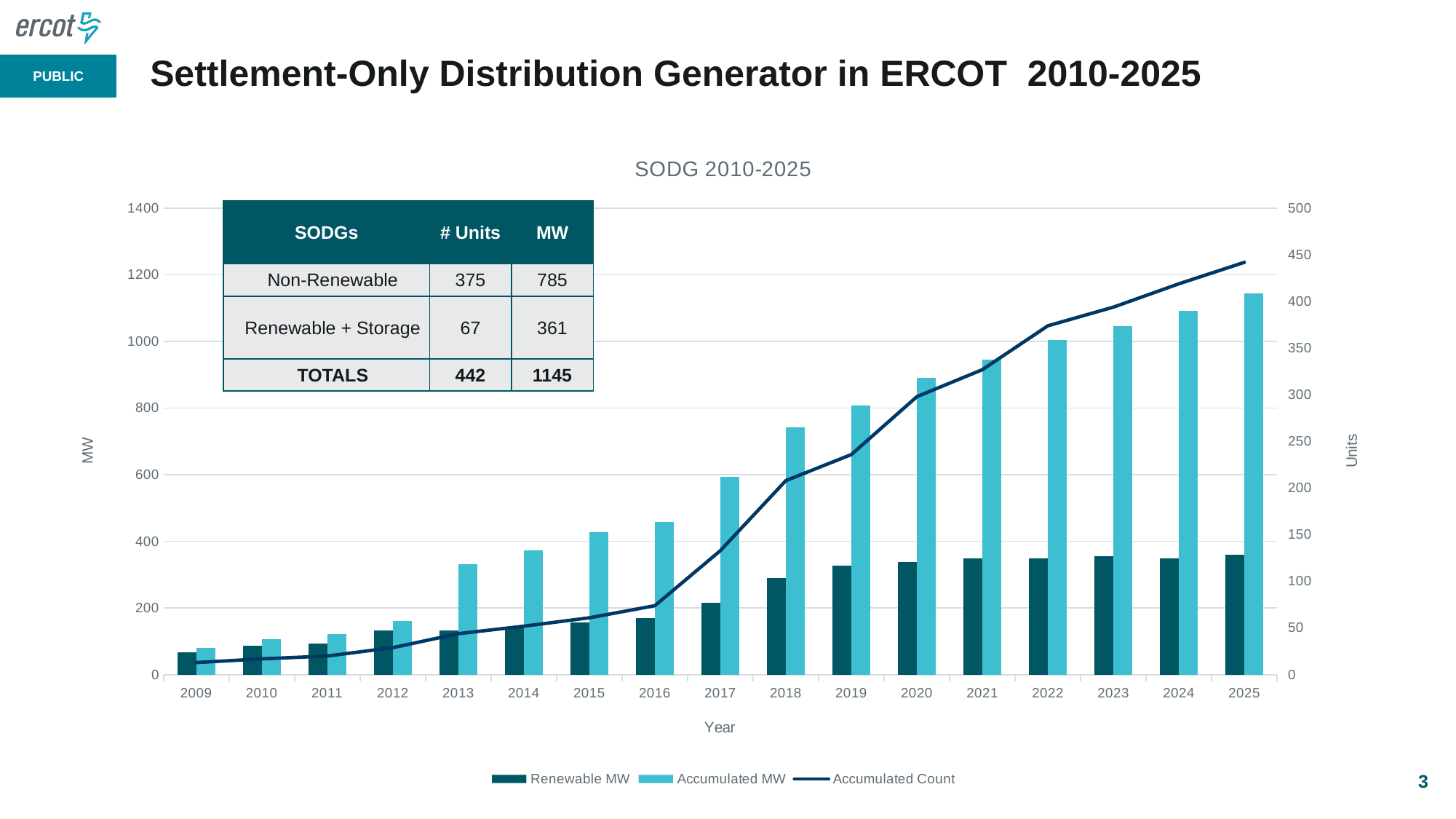
How many series does the chart legend list? 3 What is the title of the chart? SODG 2010-2025 Which year has the highest Accumulated MW bar? 2025 What kind of chart is shown on the slide? Combined bar and line chart Is the Accumulated Count value for 2025 greater or less than 400 on the right-hand Units axis? greater Is the Renewable MW value for 2025 greater or less than 400? less Is the Accumulated MW value for 2025 greater or less than 1000? greater How many years are shown along the x axis of the chart? 17 Which year has the lowest Renewable MW bar? 2009 In 2020, which is larger: the Accumulated MW bar or the Renewable MW bar? Accumulated MW Does the Accumulated Count line rise or fall from 2009 to 2025? rise